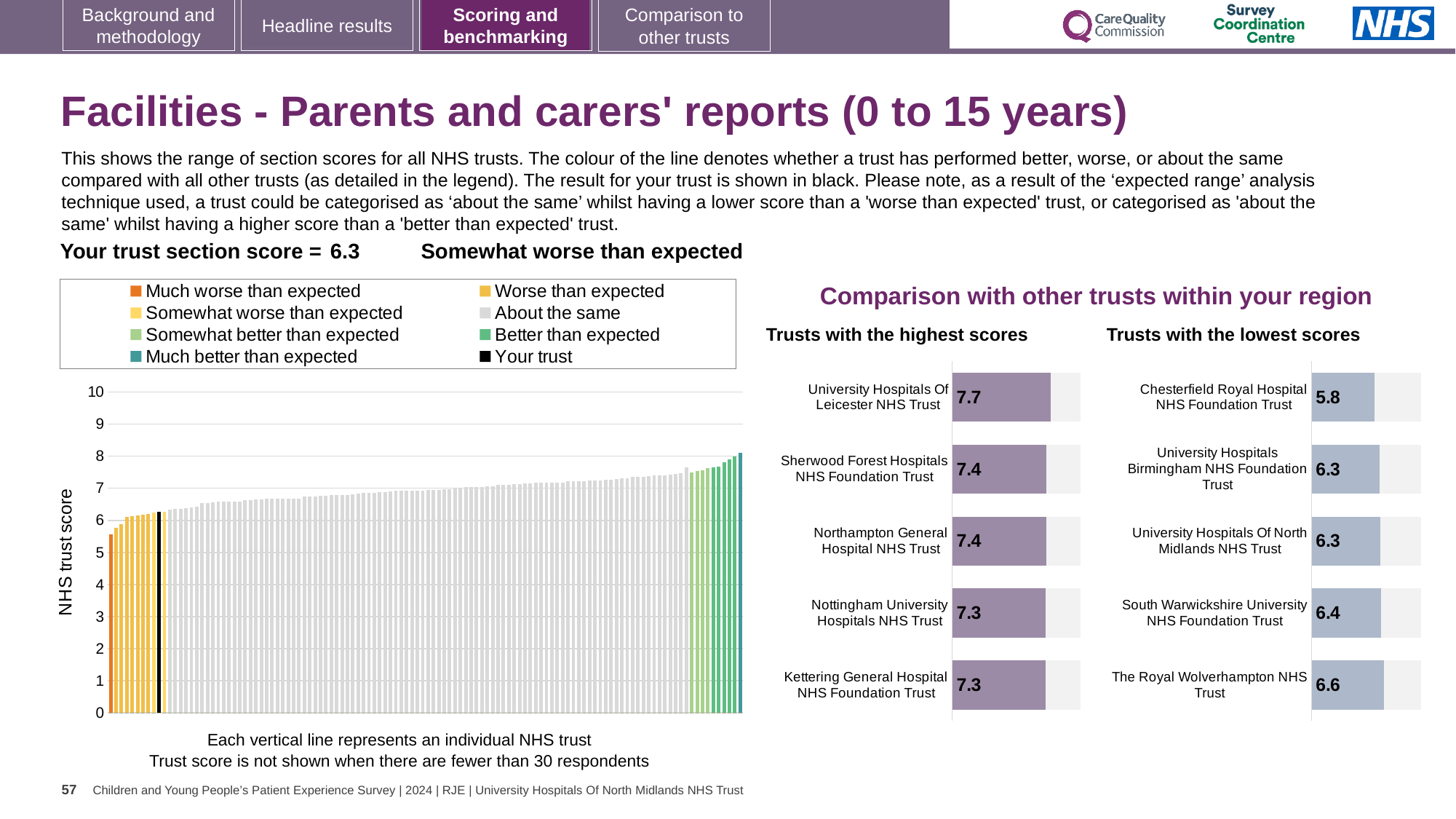
In the 'Trusts with the lowest scores' chart, what is the score for Chesterfield Royal Hospital NHS Foundation Trust? 5.8 In the 'Trusts with the highest scores' chart, what is the score for University Hospitals Of Leicester NHS Trust? 7.7 In the 'Trusts with the lowest scores' chart, what is the score for The Royal Wolverhampton NHS Trust? 6.6 In the 'Trusts with the highest scores' chart, what is the score for Kettering General Hospital NHS Foundation Trust? 7.3 In the large chart on the left, do the trust scores rise or fall from left to right? Rise In the 'Trusts with the lowest scores' chart, which trust has the lowest score? Chesterfield Royal Hospital NHS Foundation Trust In the 'Trusts with the highest scores' chart, what is the difference between the scores of University Hospitals Of Leicester NHS Trust and Nottingham University Hospitals NHS Trust? 0.4 In the 'Trusts with the highest scores' chart, which trust has the highest score? University Hospitals Of Leicester NHS Trust What kind of chart is the large chart on the left with the y-axis labelled 'NHS trust score'? Bar chart In the 'Trusts with the lowest scores' chart, what is the difference between the scores of The Royal Wolverhampton NHS Trust and Chesterfield Royal Hospital NHS Foundation Trust? 0.8 In the 'Trusts with the lowest scores' chart, which has the higher score: South Warwickshire University NHS Foundation Trust or Chesterfield Royal Hospital NHS Foundation Trust? South Warwickshire University NHS Foundation Trust How many trusts are listed in the 'Trusts with the highest scores' chart? 5